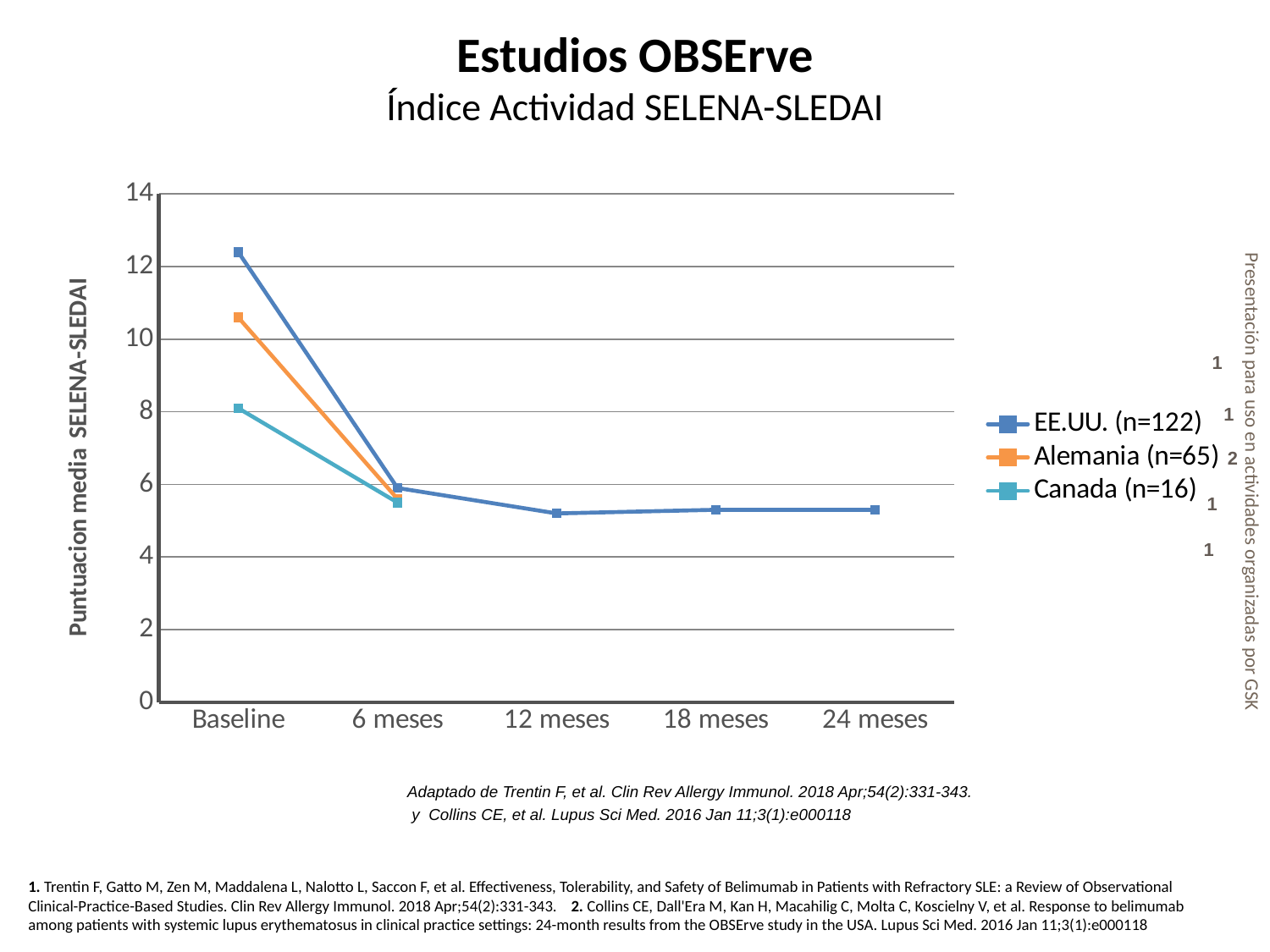
Is the Baseline value for Alemania (n=65) greater or less than 10? greater What kind of chart is shown on the slide? line chart Which series has the highest value at Baseline? EE.UU. (n=122) At Baseline, which is larger: the value for Alemania (n=65) or the value for Canada (n=16)? Alemania (n=65) Does the EE.UU. (n=122) series rise or fall from Baseline to 6 meses? fall Which series has the lowest value at Baseline? Canada (n=16) What is the label of the y axis? Puntuacion media SELENA-SLEDAI Is the value for EE.UU. (n=122) at 24 meses greater or less than 6? less How many time points are shown on the x axis? 5 Is the Baseline value for EE.UU. (n=122) greater or less than 12? greater How many series does the legend list? 3